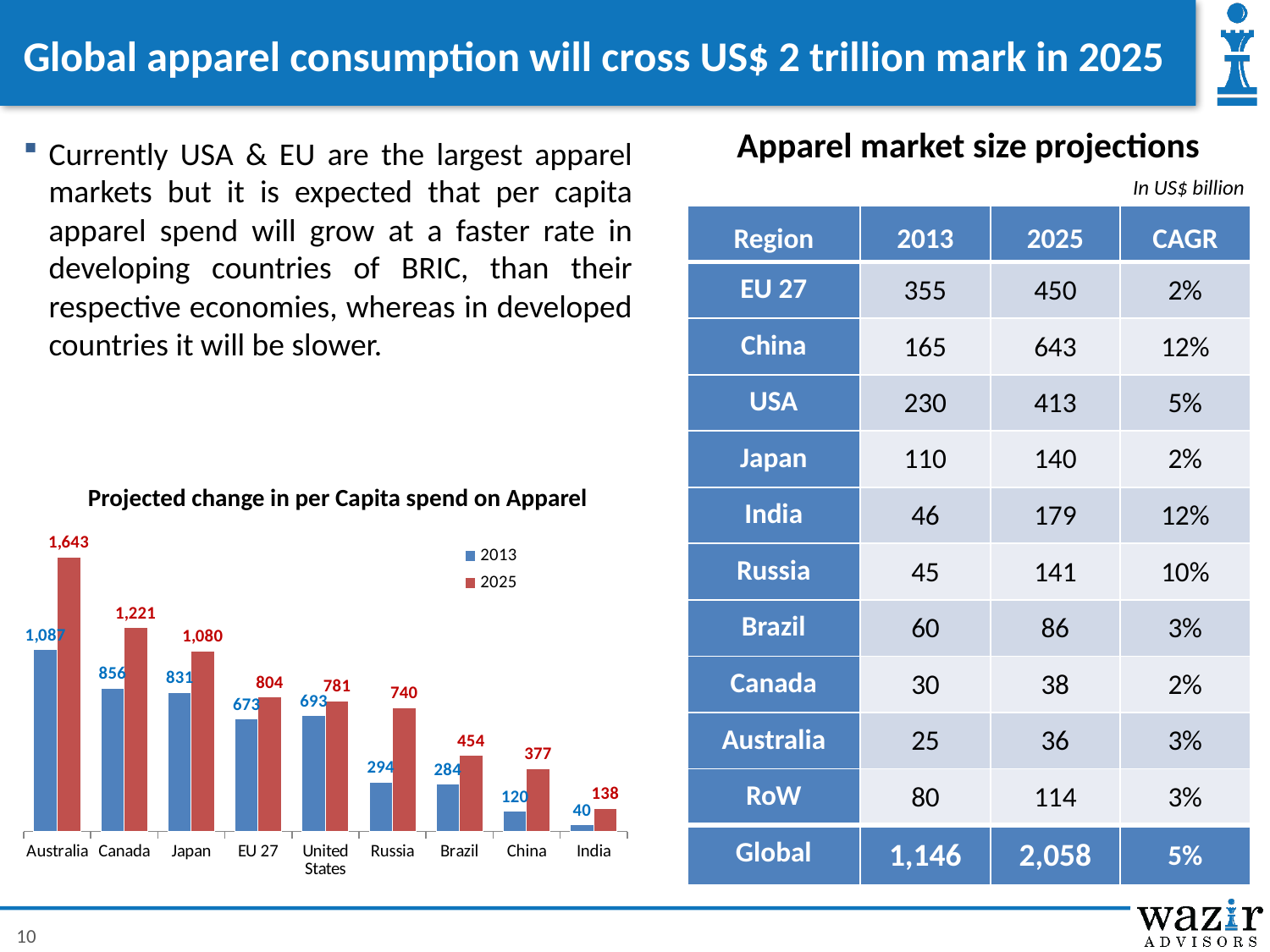
What is the 2025 value for Australia in the 'Projected change in per Capita spend on Apparel' chart? 1,643 In the 'Projected change in per Capita spend on Apparel' chart, which is larger: the 2013 value for EU 27 or the 2013 value for the United States? United States What kind of chart is 'Projected change in per Capita spend on Apparel'? Bar chart Which country has the lowest 2013 value in the 'Projected change in per Capita spend on Apparel' chart? India What is the 2013 value for Russia in the 'Projected change in per Capita spend on Apparel' chart? 294 Which country has the highest 2025 value in the 'Projected change in per Capita spend on Apparel' chart? Australia How many countries or regions are shown on the x axis of the 'Projected change in per Capita spend on Apparel' chart? 9 How many series does the legend of the 'Projected change in per Capita spend on Apparel' chart list? 2 In the 'Projected change in per Capita spend on Apparel' chart, what is the difference between the 2025 and 2013 values for Russia? 446 In the 'Projected change in per Capita spend on Apparel' chart, what is the difference between the 2025 and 2013 values for Canada? 365 What is the 2025 value for China in the 'Projected change in per Capita spend on Apparel' chart? 377 Which colour represents the 2025 series in the 'Projected change in per Capita spend on Apparel' chart? Red